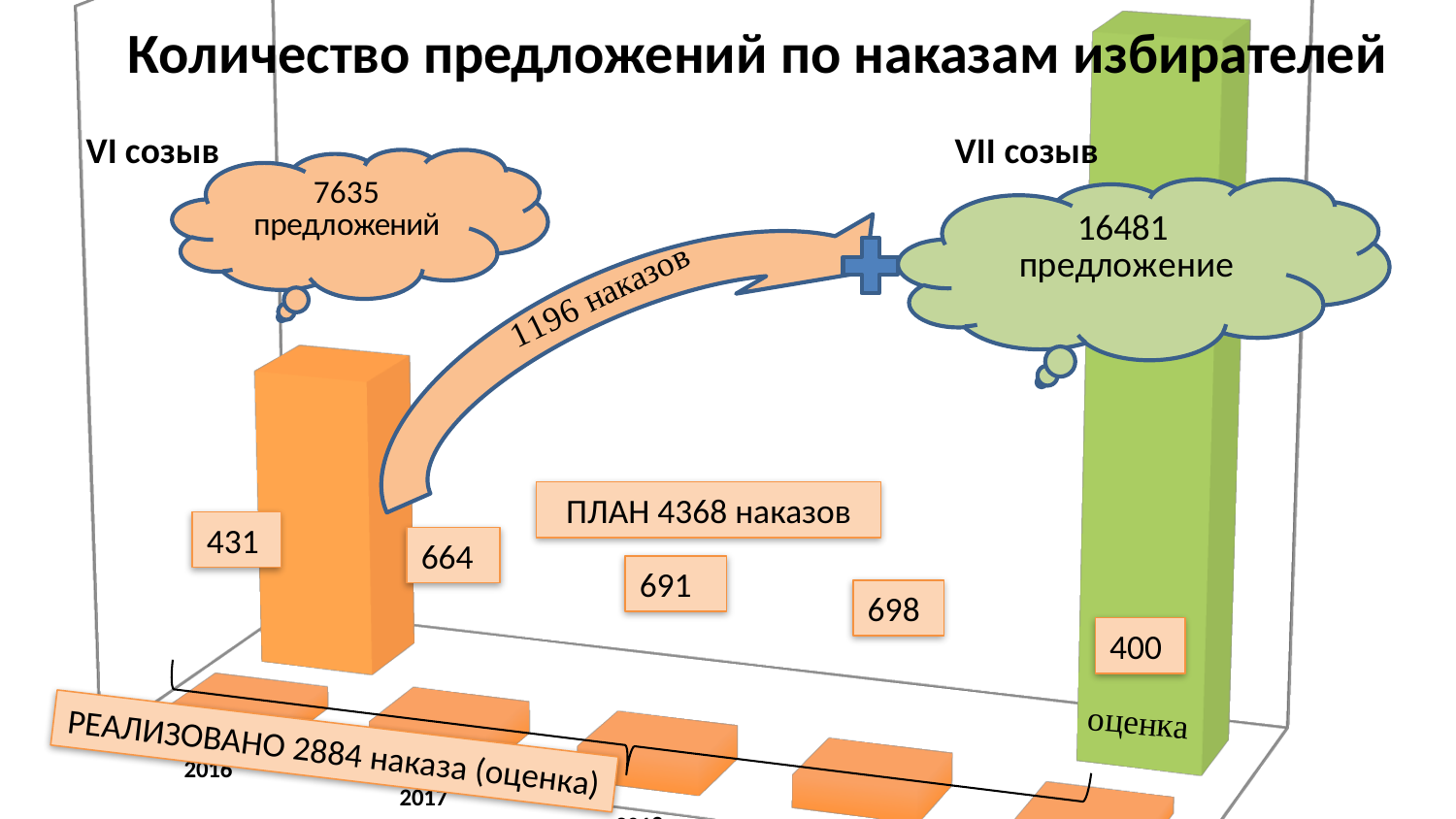
How many наказов are shown as РЕАЛИЗОВАНО (оценка)? 2884 What is the ПЛАН value of наказов shown on the chart? 4368 Which созыв has more предложений, VI or VII? VII созыв What kind of chart is shown on the slide? bar chart What is the difference between the предложений for VII созыв and VI созыв? 8846 What is the title of the chart? Количество предложений по наказам избирателей What value is labelled next to the word 'оценка' on the green bar? 400 How many предложений are shown in the callout for VI созыв? 7635 How many наказов does the arrow between the two callouts show? 1196 How many data labels are shown on the small bars along the bottom of the chart? 5 How many предложений are shown in the callout for VII созыв? 16481 What is the highest of the data labels shown on the small orange bars (431, 664, 691, 698, 400)? 698